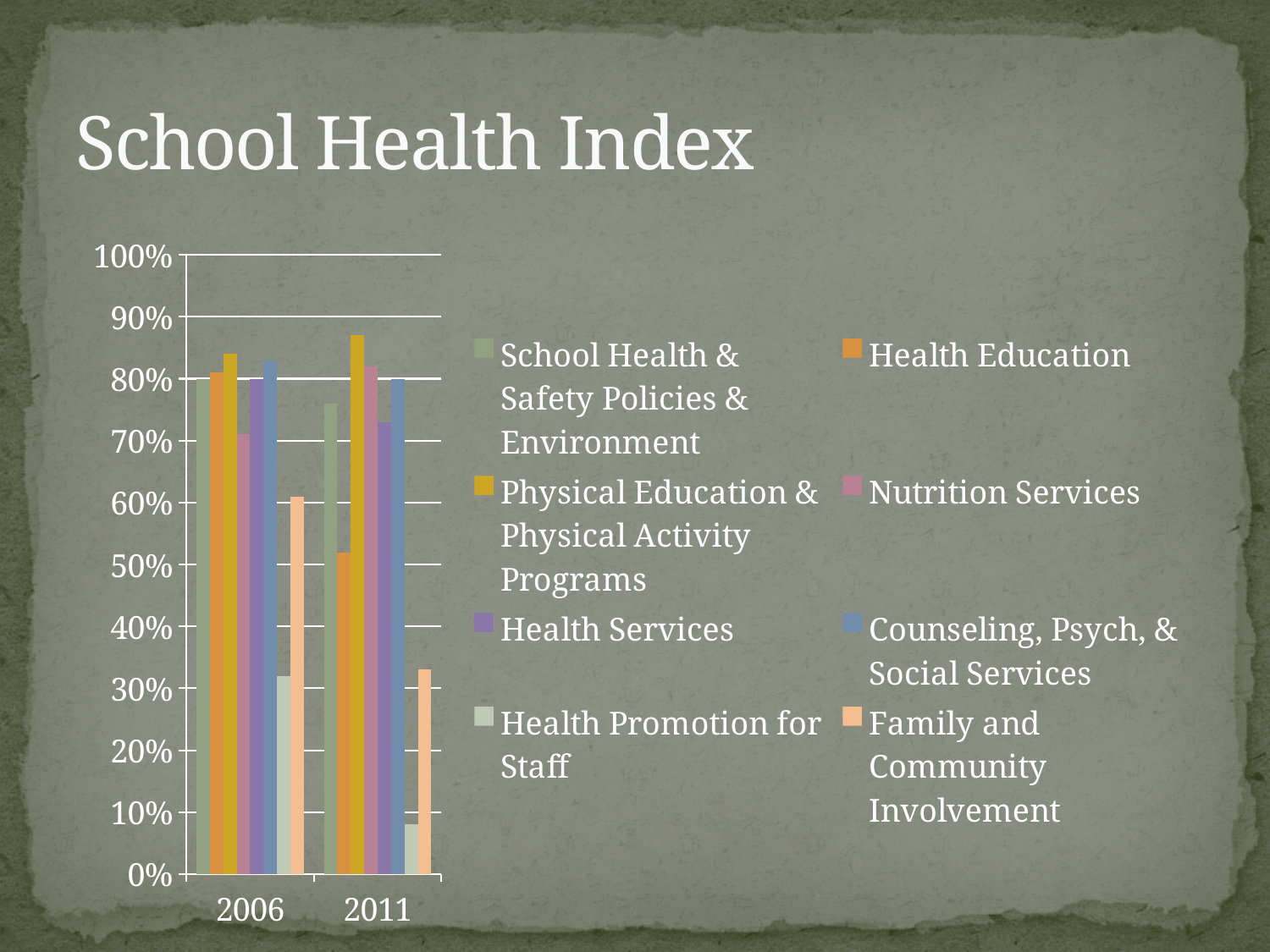
Is the value for Family and Community Involvement in 2006 greater or less than 50%? greater Is the value for Health Education in 2011 greater or less than 60%? less What kind of chart is shown on the slide? bar chart How many series does the legend list? 8 Is the value for Health Promotion for Staff larger in 2006 or in 2011? 2006 Is the value for Health Promotion for Staff in 2011 greater or less than 20%? less How many year categories are shown on the x axis? 2 Does the value for Family and Community Involvement rise or fall from 2006 to 2011? fall Which series has the highest value in 2011? Physical Education & Physical Activity Programs Which series has the lowest value in 2006? Health Promotion for Staff What is the title of the slide's chart? School Health Index Which series has the lowest value in 2011? Health Promotion for Staff